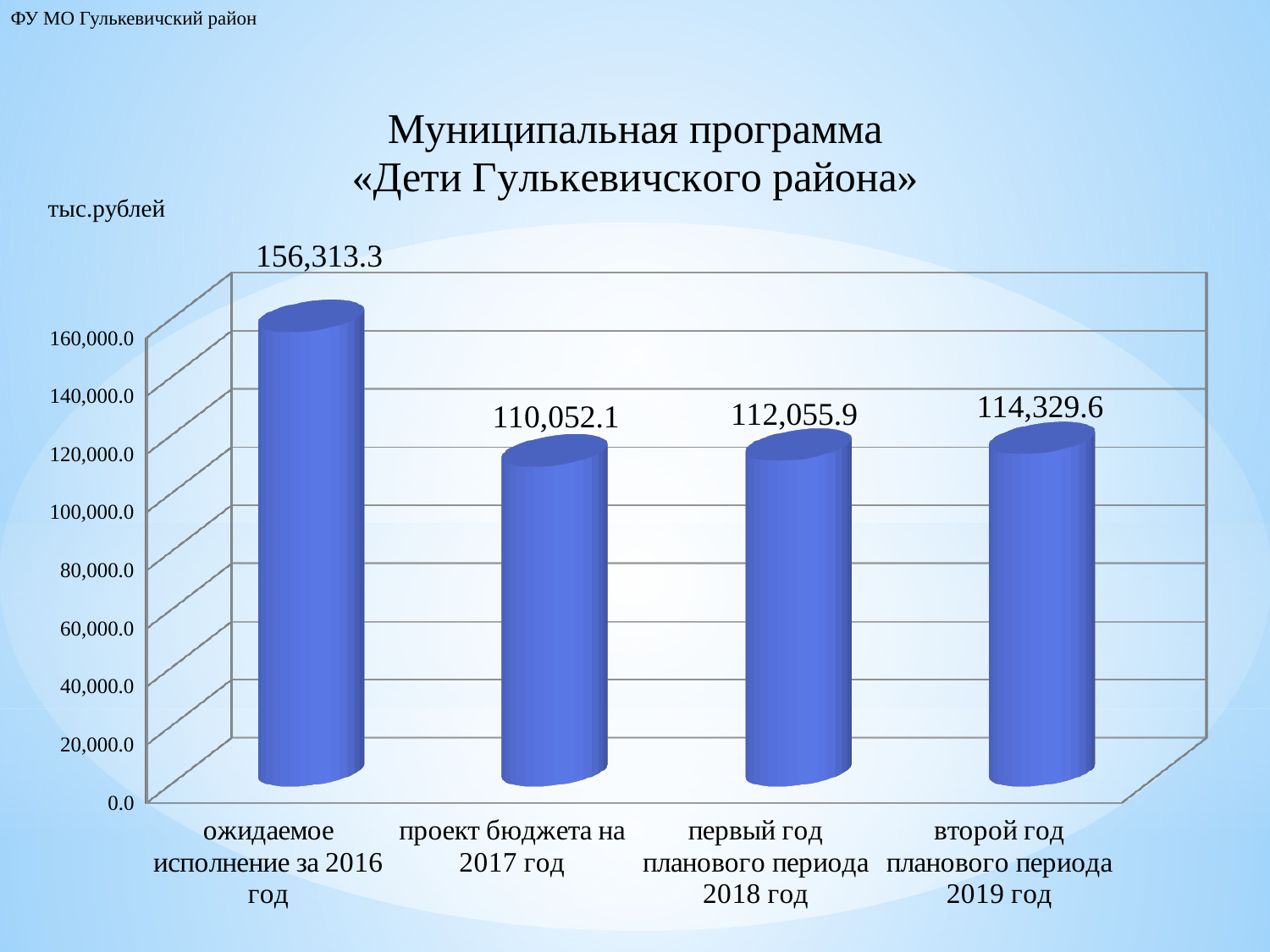
What is the difference between the value for 2019 and the value for 2018? 2,273.7 How many categories are shown on the chart? 4 Which category has the lowest value? проект бюджета на 2017 год What is the value for 'ожидаемое исполнение за 2016 год'? 156,313.3 Which category has the highest value? ожидаемое исполнение за 2016 год What is the value for 'первый год планового периода 2018 год'? 112,055.9 Do the values rise or fall from 2017 to 2019? rise What is the value for 'второй год планового периода 2019 год'? 114,329.6 What kind of chart is shown on the slide? bar chart What is the value for 'проект бюджета на 2017 год'? 110,052.1 What is the difference between the value for 2016 (ожидаемое исполнение) and the value for 2017 (проект бюджета)? 46,261.2 Which is larger, the value for 2018 or the value for 2019? 2019